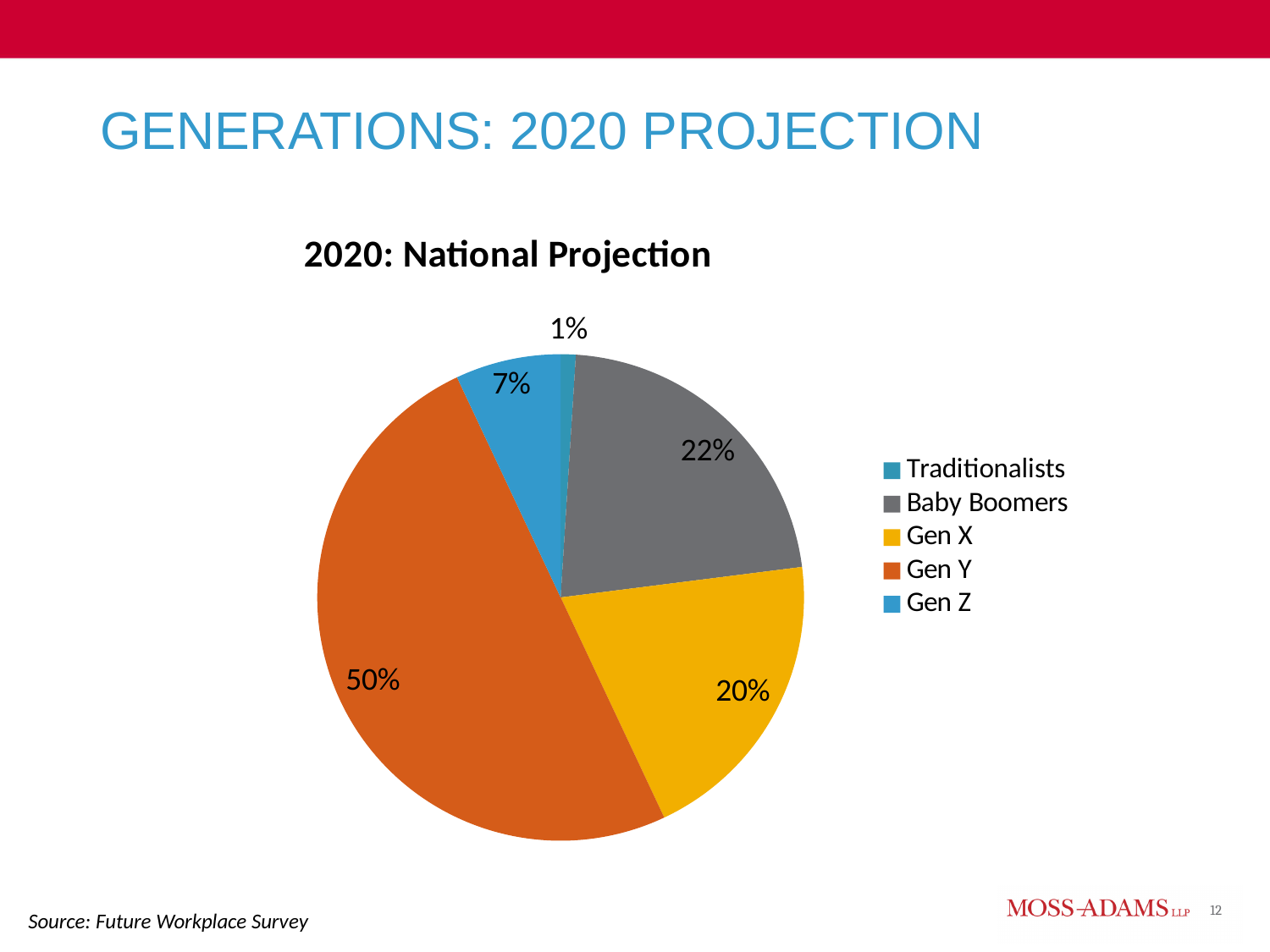
What share of the pie is Traditionalists? 1% What share of the pie is Gen X? 20% What share of the pie is Gen Y? 50% What kind of chart is shown on the slide? pie chart Which is larger, the share for Gen X or the share for Gen Z? Gen X Which generation has the largest share of the pie? Gen Y What is the difference between the Gen Y share and the Baby Boomers share? 28% Which generation has the smallest share of the pie? Traditionalists What is the chart's title? 2020: National Projection What share of the pie is Gen Z? 7% What share of the pie is Baby Boomers? 22% How many categories does the legend list? 5